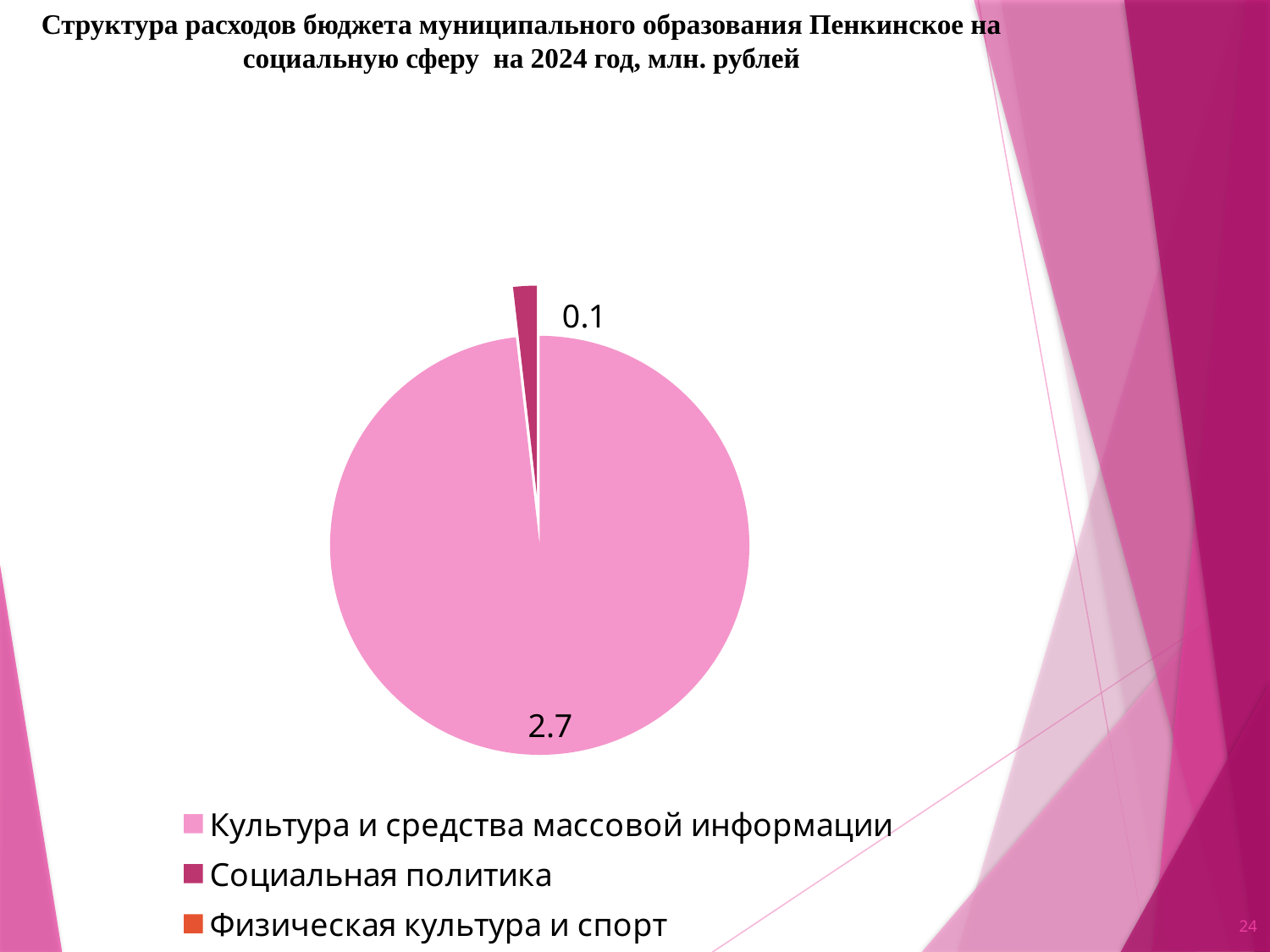
What is the value for Социальная политика? 0.1 How many categories does the legend list? 3 What type of chart is shown on the slide? pie chart What is the difference between the value for Культура и средства массовой информации and the value for Социальная политика? 2.6 What colour is the slice for Социальная политика? dark magenta In what units are the values given, according to the title? млн. рублей How many slices have a data label printed on the pie? 2 What is the value for Культура и средства массовой информации? 2.7 Which is larger, the value for Культура и средства массовой информации or the value for Социальная политика? Культура и средства массовой информации Which category has the largest slice of the pie? Культура и средства массовой информации What year does the chart title refer to? 2024